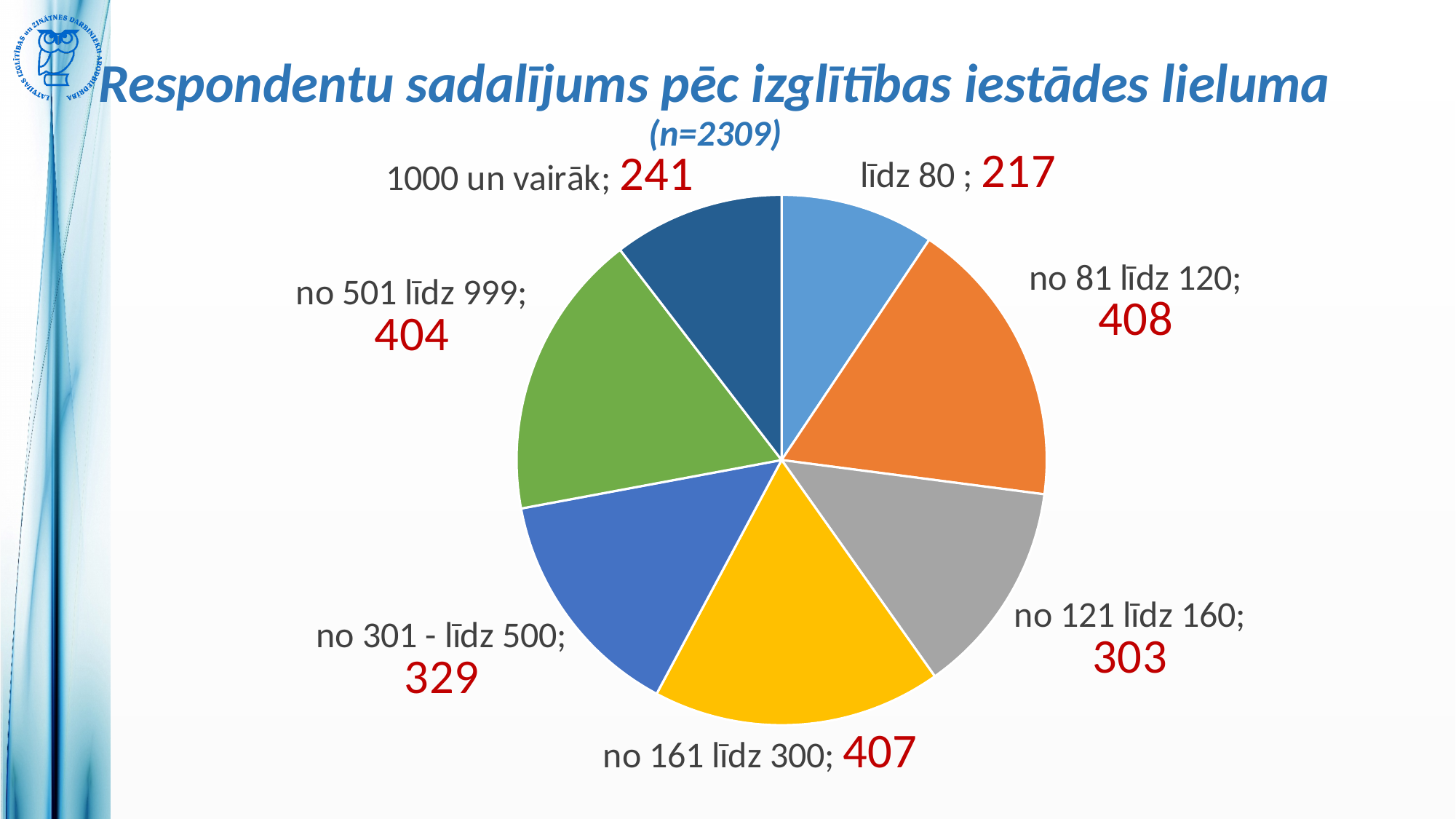
Which is larger: the value for "no 301 - līdz 500" or the value for "no 121 līdz 160"? no 301 - līdz 500 What is the difference between the values for "no 81 līdz 120" and "no 121 līdz 160"? 105 What is the value for the category "no 501 līdz 999"? 404 Which category has the lowest value? līdz 80 What is the value for the category "no 81 līdz 120"? 408 What is the difference between the values for "no 501 līdz 999" and "1000 un vairāk"? 163 What is the value for the category "no 161 līdz 300"? 407 What is the value for the category "līdz 80"? 217 How many categories (slices) does the pie chart have? 7 What is the total number of respondents (n) stated under the chart title? 2309 What is the title of the chart? Respondentu sadalījums pēc izglītības iestādes lieluma What kind of chart is shown on the slide? pie chart